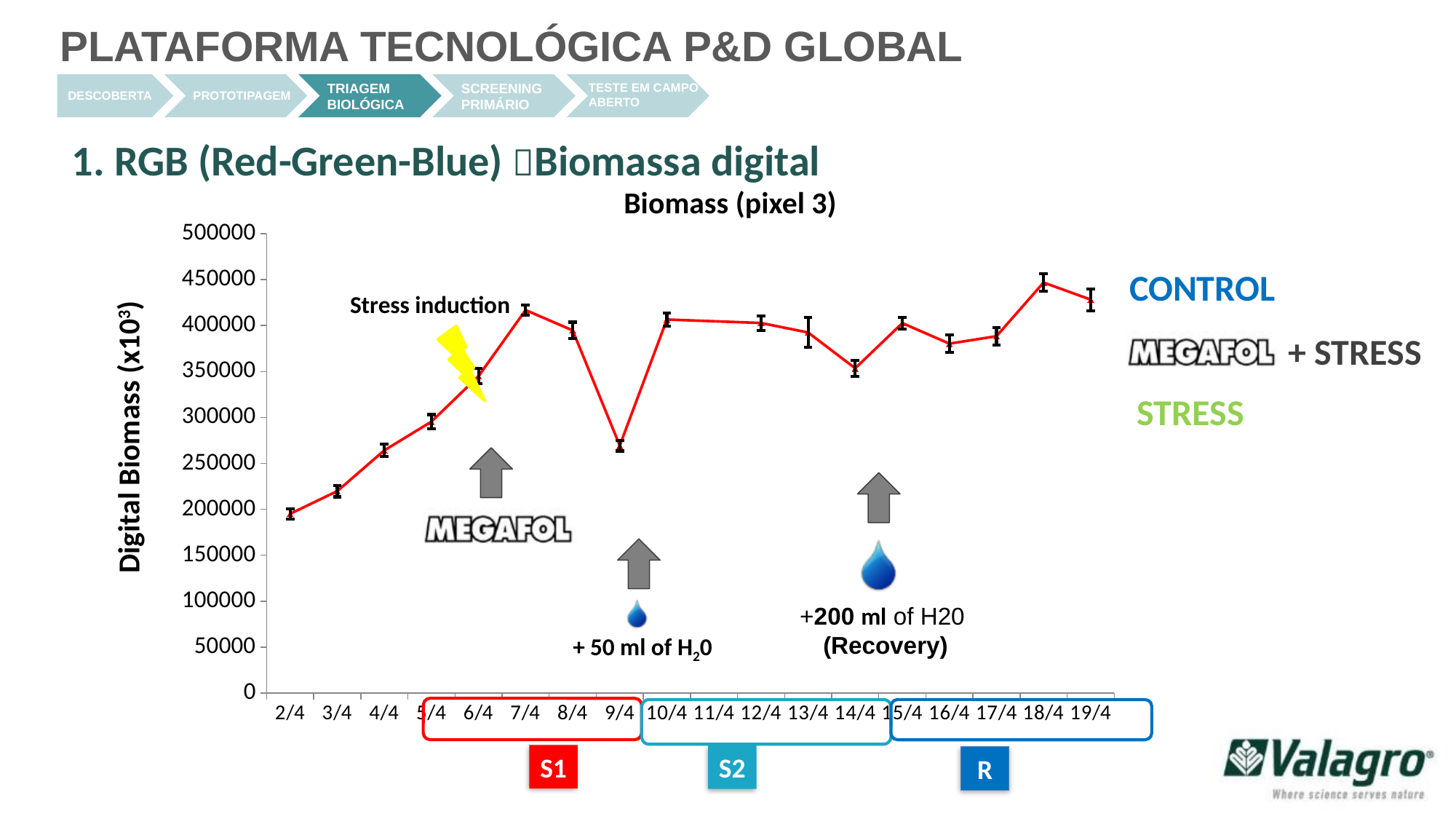
What is the title of the chart? Biomass (pixel 3) Is the value for 9/4 greater or less than 300000? less Is the value for 18/4 greater or less than 400000? greater Is the value for 7/4 greater or less than 400000? greater Do the values rise or fall from 2/4 to 7/4? Rise Which date has the larger value, 9/4 or 10/4? 10/4 How many dates are plotted along the x axis of the chart? 18 On which date is the plotted biomass value lowest? 2/4 On which date is the plotted biomass value highest? 18/4 What is the label of the y axis of the chart? Digital Biomass (x10³) What kind of chart is shown on the slide? Line chart